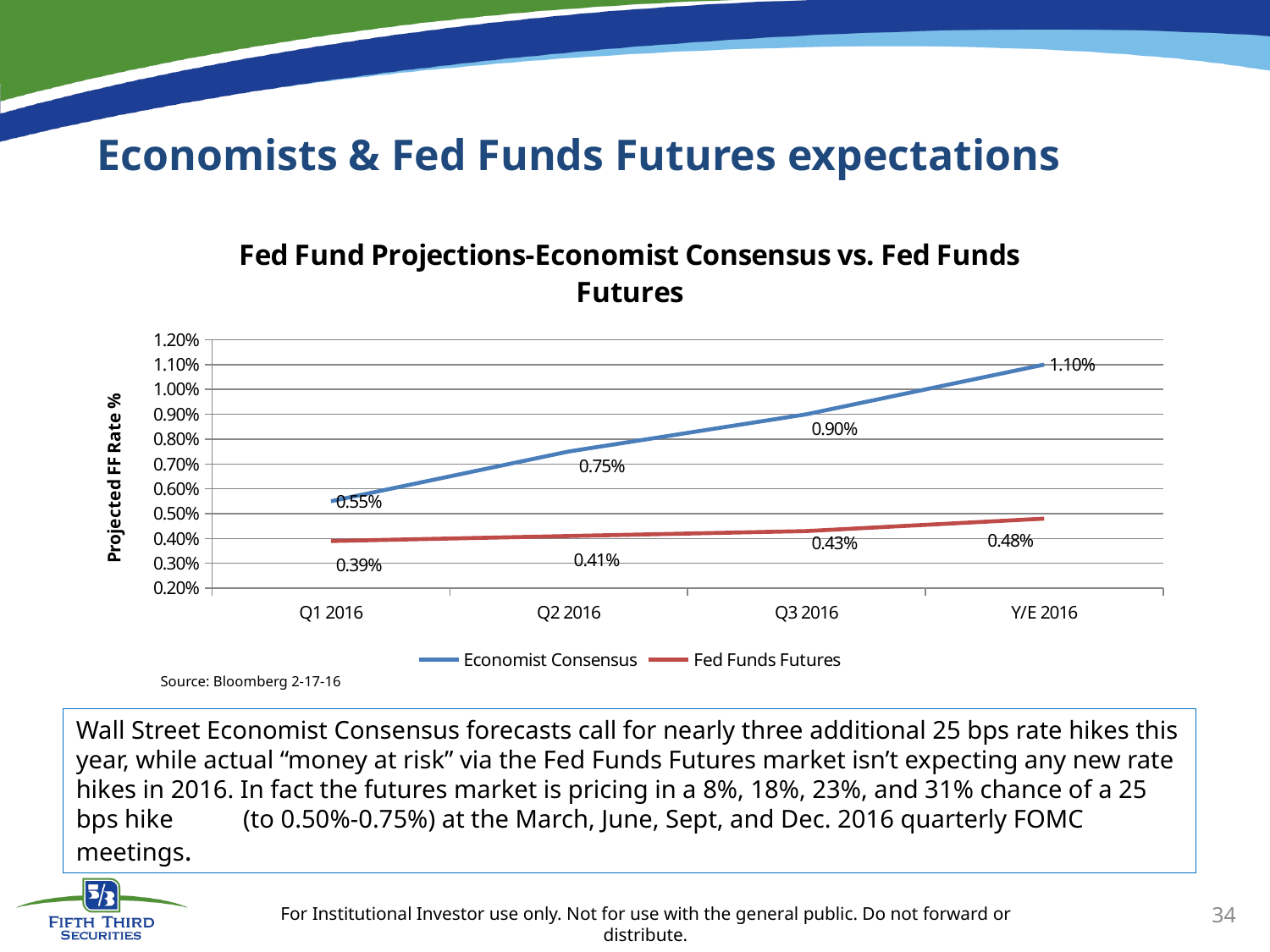
Does the Economist Consensus series rise or fall from Q1 2016 to Y/E 2016? rise Is the Economist Consensus value for Q3 2016 greater or less than 1.00%? less What is the difference between the Economist Consensus and Fed Funds Futures values at Y/E 2016? 0.62% What is the Fed Funds Futures value for Q1 2016? 0.39% At which point is the Fed Funds Futures series lowest? Q1 2016 How many points are plotted along the x axis? 4 At which point is the Economist Consensus series highest? Y/E 2016 What is the Fed Funds Futures value for Y/E 2016? 0.48% Which is larger at Q3 2016: the Economist Consensus value or the Fed Funds Futures value? Economist Consensus What kind of chart is shown? line chart What is the Economist Consensus value for Q2 2016? 0.75% How many series does the legend list? 2